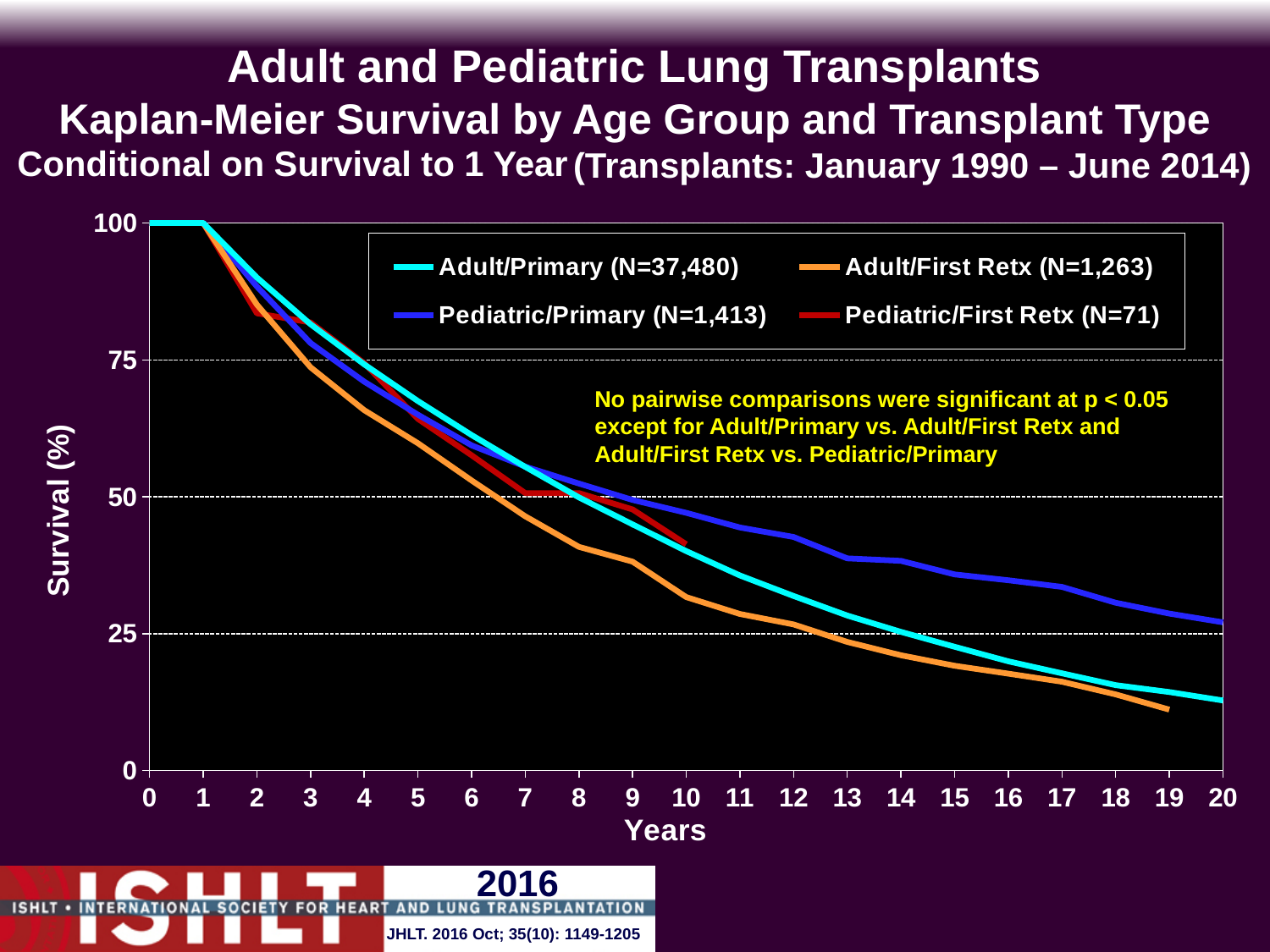
What kind of chart is shown on the slide? Line chart Is the survival value for Adult/Primary at 5 years greater or less than 50? greater Is the survival value for Adult/Primary at 20 years greater or less than 25? less How many series does the legend list? 4 What is the N value shown in the legend for the Pediatric/First Retx series? N=71 What is the N value shown in the legend for the Adult/Primary series? N=37,480 At 15 years, which series has the higher survival: Pediatric/Primary or Adult/Primary? Pediatric/Primary Is the survival value for Adult/First Retx at 10 years greater or less than 50? less At 10 years, which series has the higher survival: Adult/Primary or Adult/First Retx? Adult/Primary Which series has the lowest survival at 10 years? Adult/First Retx What is the survival (%) for all four series at 1 year? 100 Do the survival curves rise or fall as years increase? Fall